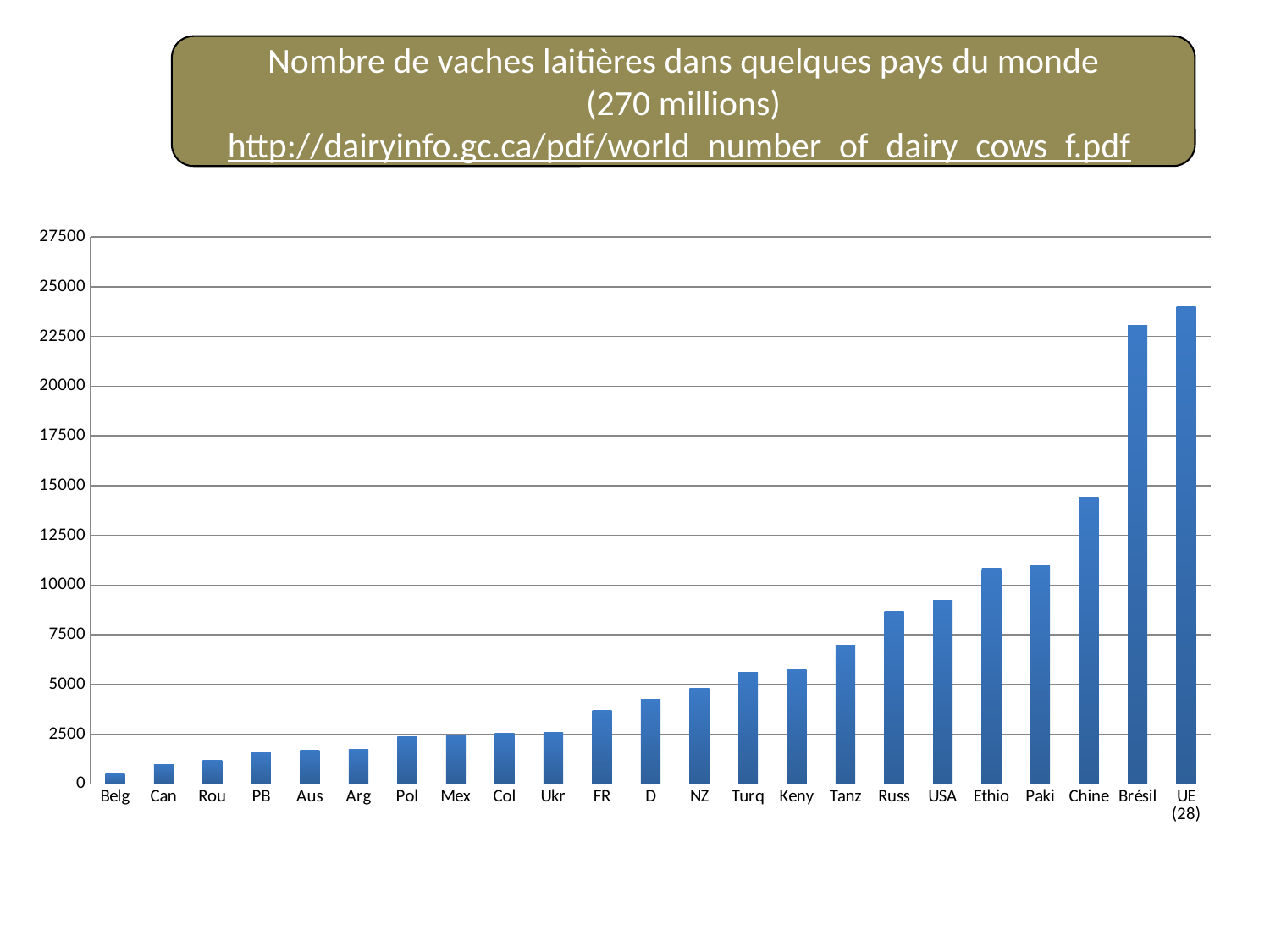
Which is larger, the value for Chine or the value for USA? Chine Is the value for USA greater or less than 10000? less What kind of chart is shown on the slide? bar chart Is the value for D greater or less than 5000? less Which category has the lowest value? Belg Is the value for Chine greater or less than 12500? greater Which category has the highest value? UE (28) How many categories are plotted on the x axis? 23 Do the values rise or fall from left to right along the x axis? rise What is the first line of the chart's title? Nombre de vaches laitières dans quelques pays du monde